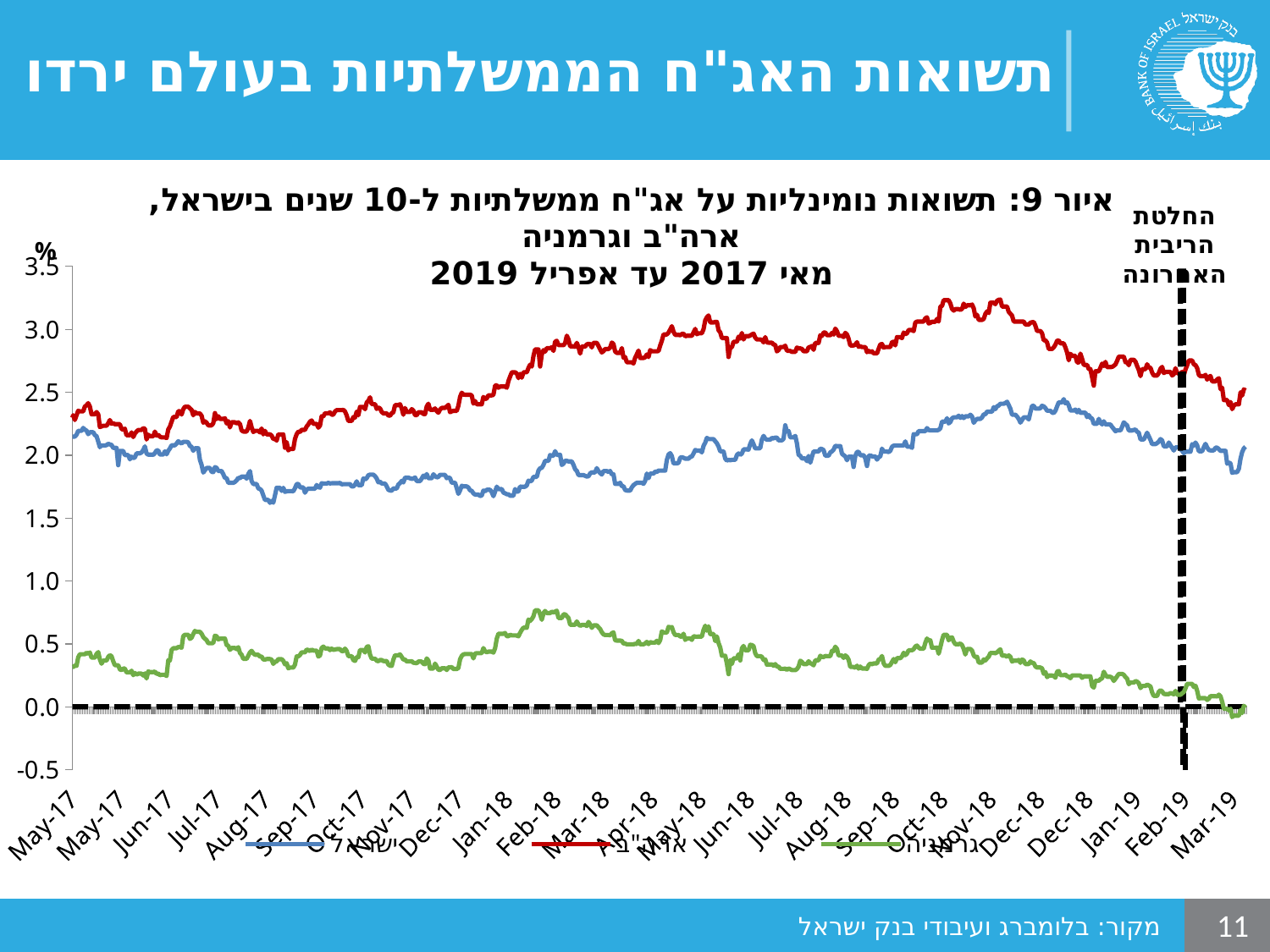
Which series has the lowest values across the whole period? גרמניה How many series does the legend list? 3 Is the value for גרמניה in Mar-19 greater or less than 0.5? less What does the vertical dashed line near Feb-19 mark, according to its label? החלטת הריבית האחרונה Does the value for גרמניה rise or fall from Oct-18 to Mar-19? fall In Jan-18, which is larger: the value for ישראל or the value for גרמניה? ישראל What unit is shown on the y axis? % Is the value for ארה"ב in Oct-18 greater or less than 3.0? greater Which series has the highest values across the whole period? ארה"ב What kind of chart is shown on the slide? line chart Is the value for ישראל in Aug-17 greater or less than 2.0? less